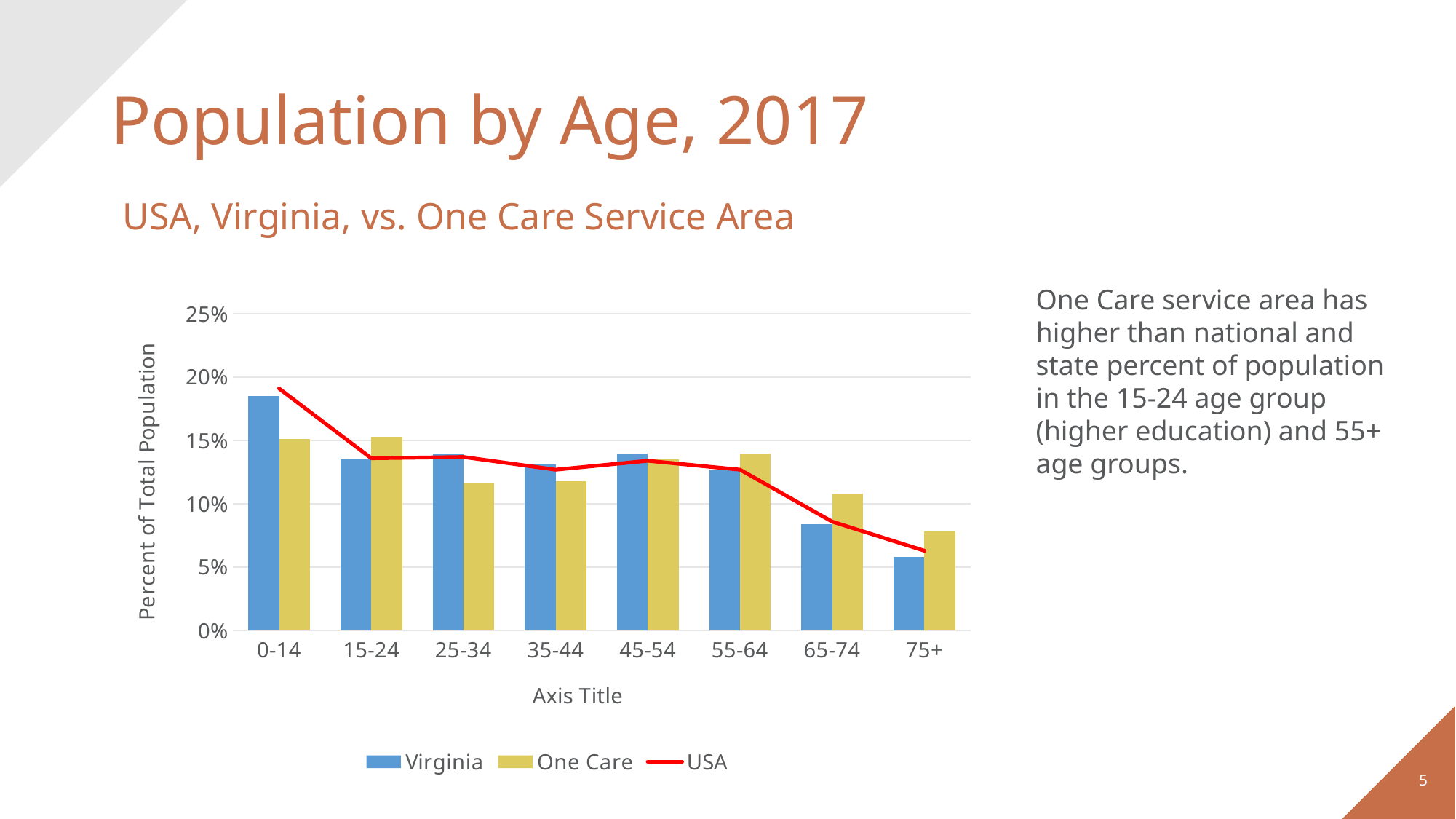
How many series does the legend list? 3 Which age group has the lowest value for One Care? 75+ Is the One Care value for the 65-74 age group greater or less than 10%? greater Which age group has the lowest value for Virginia? 75+ Is the Virginia value for the 0-14 age group greater or less than 15%? greater In the 75+ age group, which is larger: Virginia or One Care? One Care Which age group has the highest value for Virginia? 0-14 In the 0-14 age group, which is larger: Virginia or One Care? Virginia What is the label on the vertical axis? Percent of Total Population What kind of chart is shown on the slide? Bar chart with a line Is the Virginia value for the 65-74 age group greater or less than 10%? less How many age groups are shown on the x axis? 8